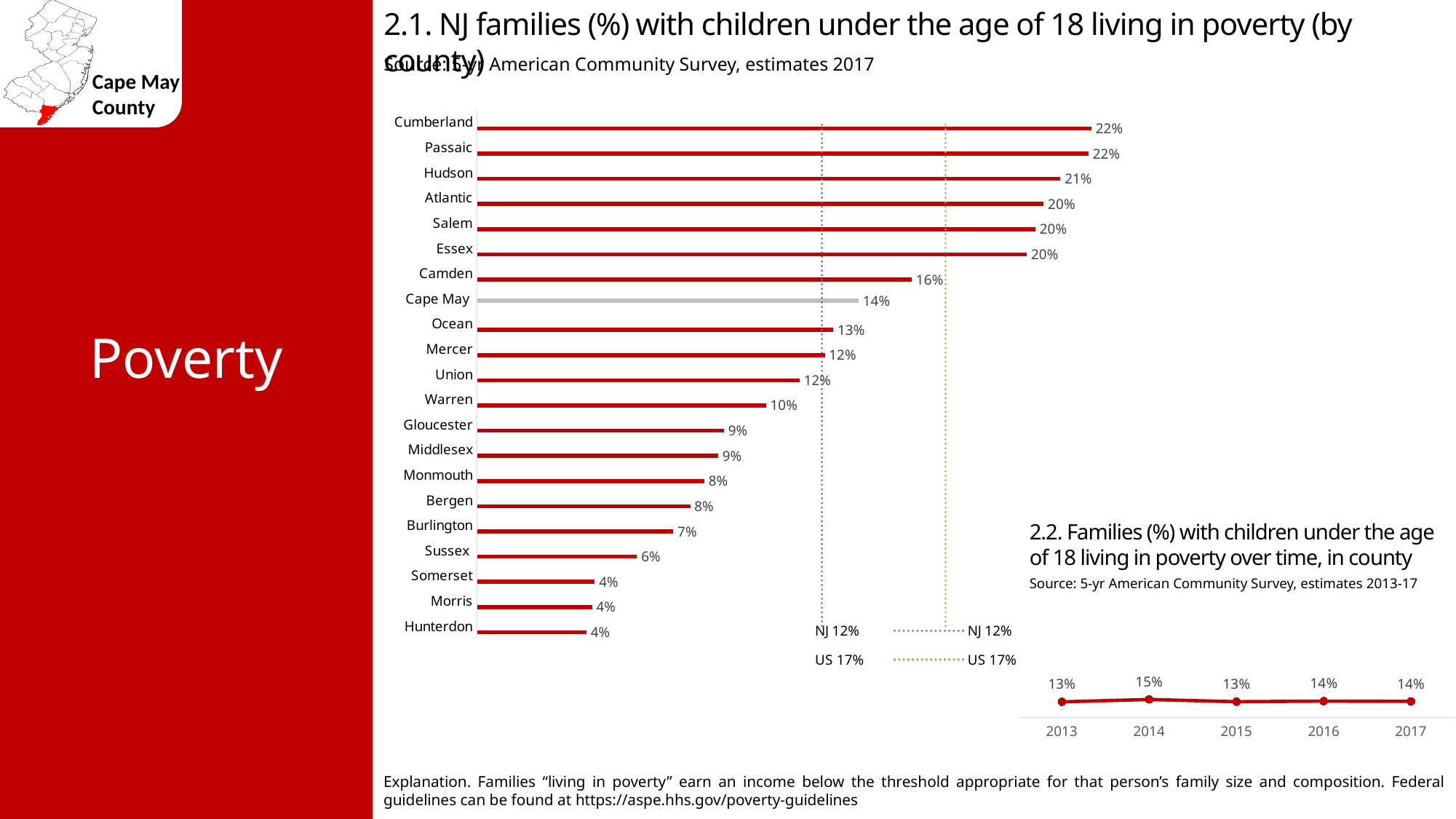
In chart 2.1, what is the value for Hunterdon? 4% In chart 2.1, what is the difference between the value for Cumberland and the value for Cape May? 8 percentage points In chart 2.2, how many years are plotted? 5 In chart 2.2 (families with children under 18 living in poverty over time), what is the value for 2014? 15% In chart 2.1 (NJ families with children under 18 living in poverty by county), what is the value for Cape May? 14% In chart 2.1, what value does the dotted reference line labelled US show? 17% In chart 2.1, what is the value for Camden? 16% In chart 2.1, how many counties are plotted? 21 In chart 2.1, what kind of chart is used? Bar chart In chart 2.2, what is the difference between the value for 2014 and the value for 2013? 2 percentage points In chart 2.2, which year has the highest value? 2014 In chart 2.1, which is larger, the value for Camden or the value for Ocean? Camden